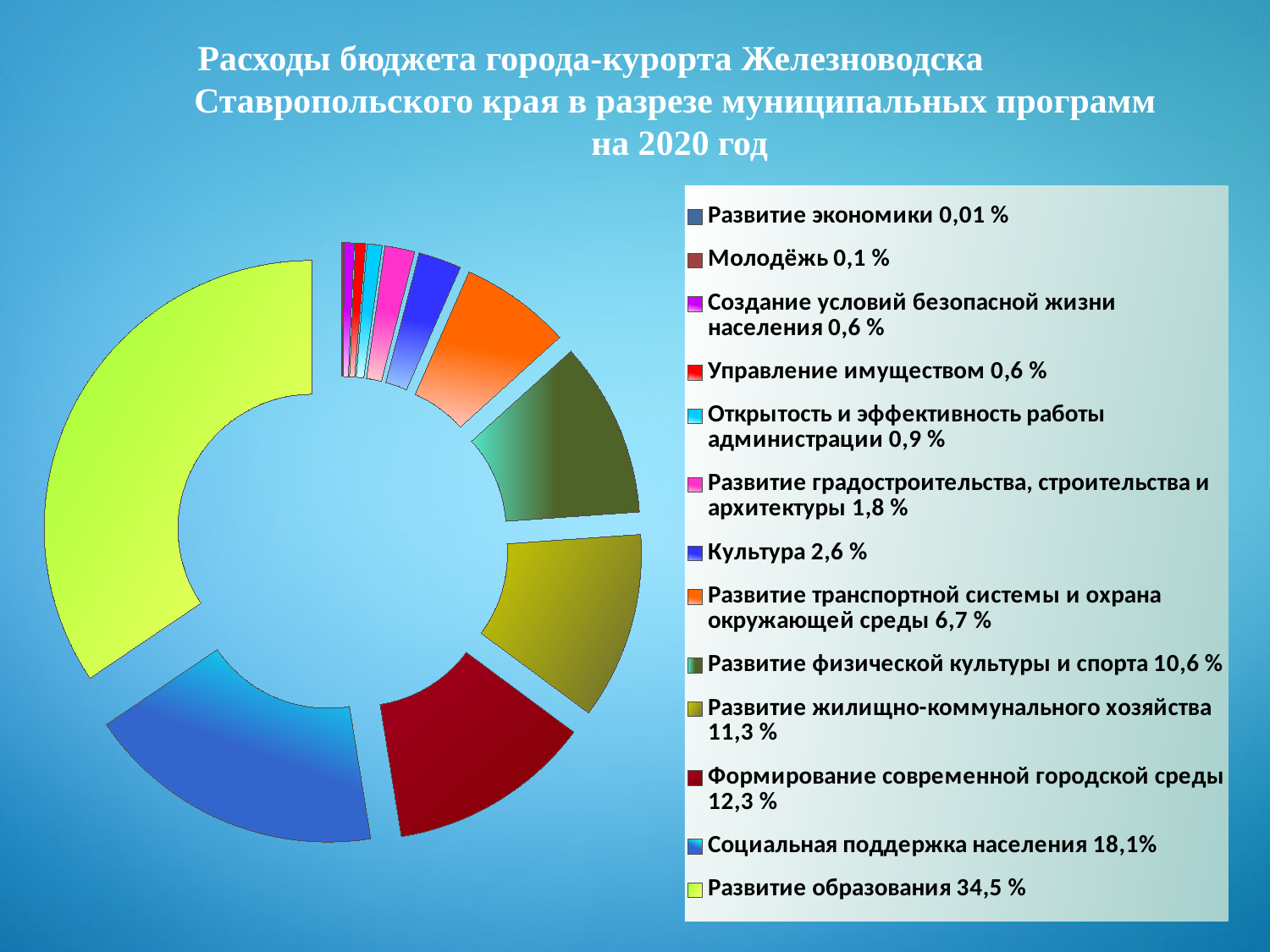
Which program has the smallest share of the budget? Развитие экономики What year does the chart title refer to? 2020 What percentage is listed for Культура? 2,6 % What share of the budget goes to Развитие образования? 34,5 % Which program has the largest share of the budget? Развитие образования What is the value shown for Социальная поддержка населения? 18,1% Which is larger: Развитие физической культуры и спорта or Развитие жилищно-коммунального хозяйства? Развитие жилищно-коммунального хозяйства What is the value for Развитие транспортной системы и охрана окружающей среды? 6,7 % What is the difference between Формирование современной городской среды and Развитие жилищно-коммунального хозяйства? 1,0 % What kind of chart is shown on the slide? Doughnut (pie) chart How many programs (categories) are shown in the chart? 13 What is the difference between the shares of Развитие образования and Социальная поддержка населения? 16,4 %